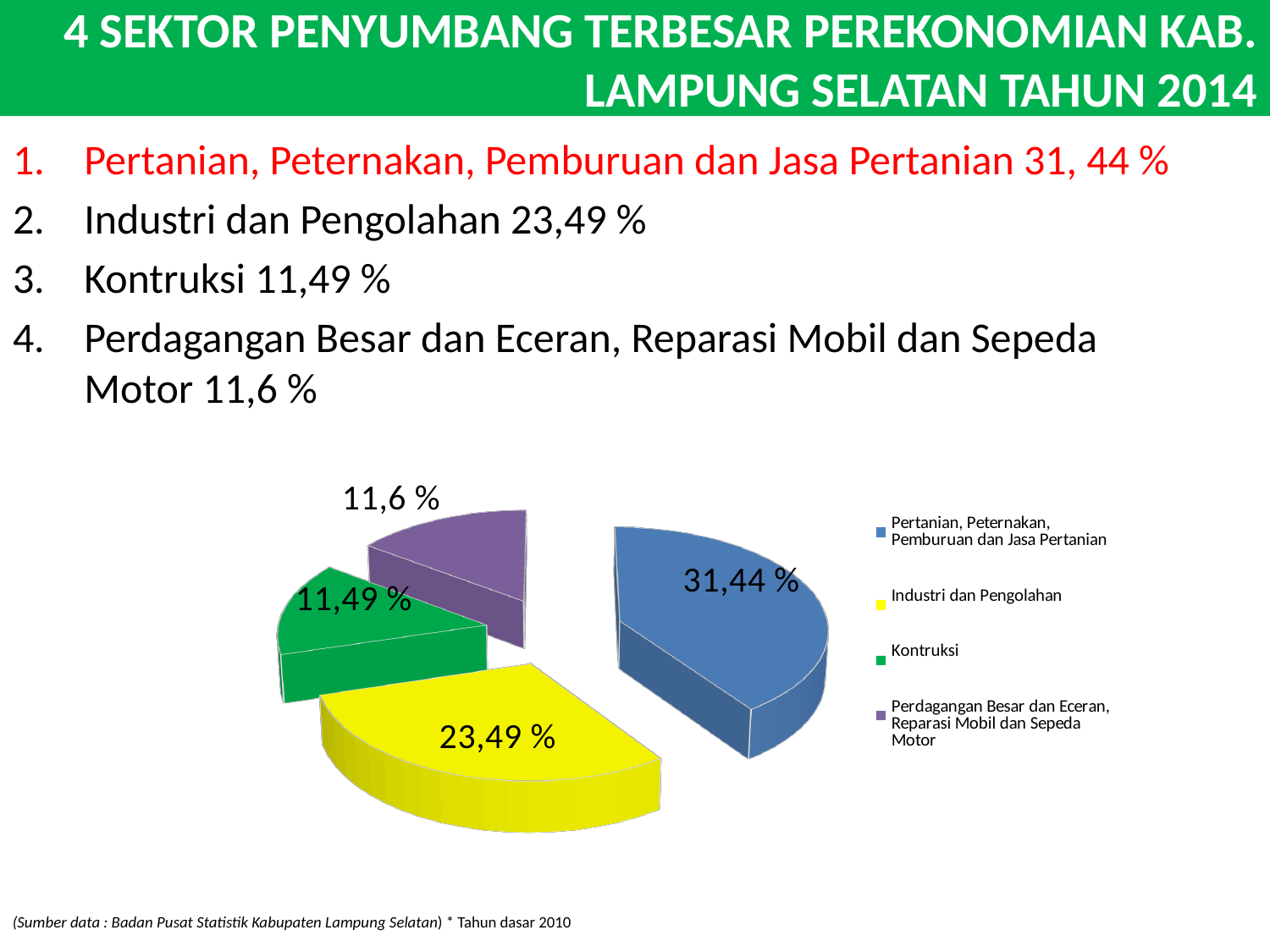
What type of chart is shown on the slide? Pie chart How many entries does the legend list? 4 What value is shown for Kontruksi in the pie chart? 11,49 % What colour is the Industri dan Pengolahan slice? Yellow What value is shown for Industri dan Pengolahan in the pie chart? 23,49 % What is the difference between the Pertanian, Peternakan, Pemburuan dan Jasa Pertanian slice and the Industri dan Pengolahan slice? 7,95 % Which sector has the largest slice of the pie? Pertanian, Peternakan, Pemburuan dan Jasa Pertanian Which is larger, the Industri dan Pengolahan slice or the Kontruksi slice? Industri dan Pengolahan How many slices does the pie chart have? 4 What value is shown for Perdagangan Besar dan Eceran, Reparasi Mobil dan Sepeda Motor? 11,6 % What share of the pie does Pertanian, Peternakan, Pemburuan dan Jasa Pertanian have? 31,44 % Which sector has the smallest slice of the pie? Kontruksi